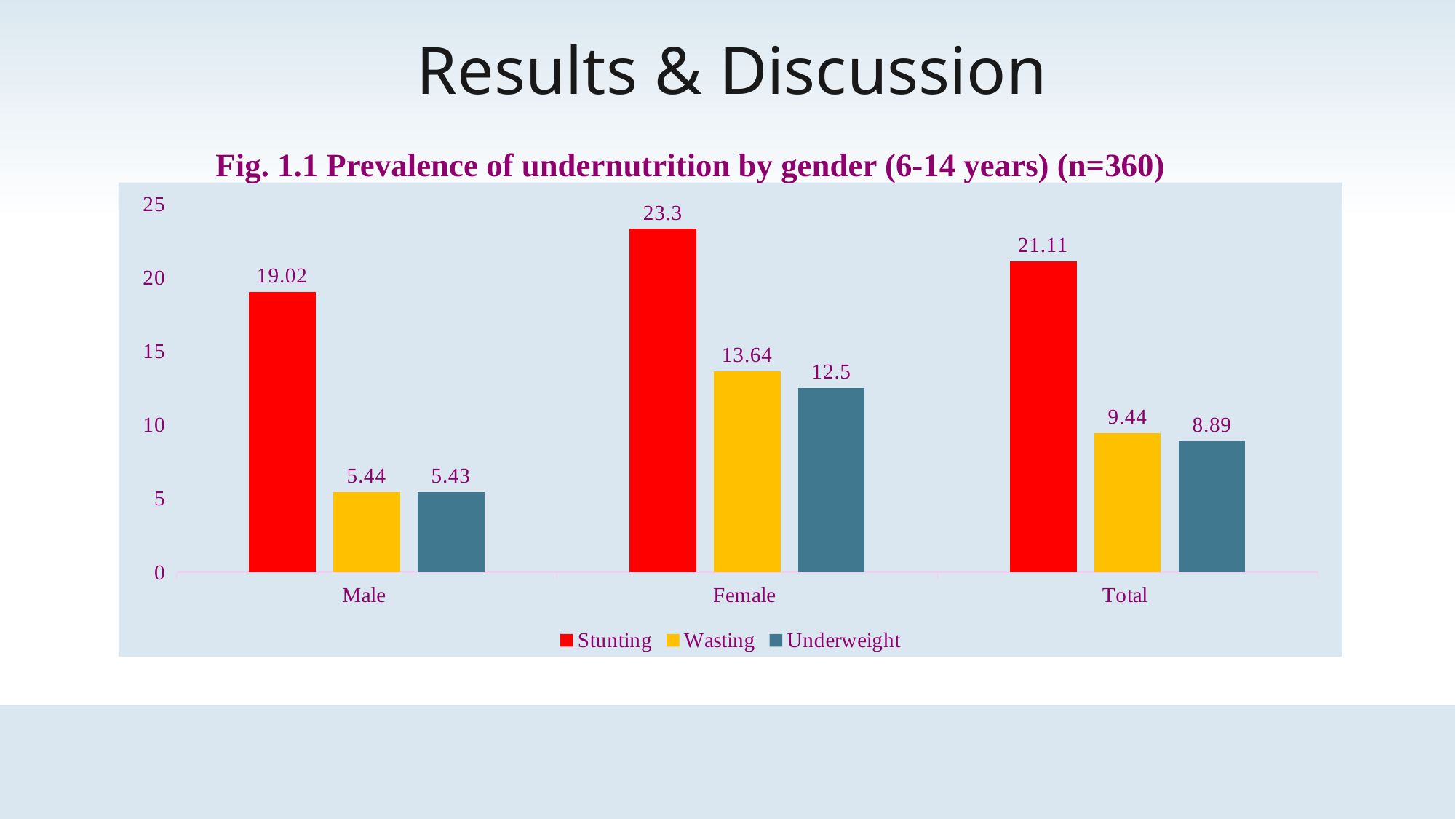
Which category has the highest Stunting value? Female Is the Stunting value for Total greater or less than 20? greater What is the Underweight value for Total? 8.89 What is the Wasting value for Male? 5.44 How many categories are shown on the x axis? 3 What is the title of the chart? Fig. 1.1 Prevalence of undernutrition by gender (6-14 years) (n=360) What is the difference between the Stunting values for Female and Male? 4.28 What kind of chart is shown? bar chart Which is larger, the Wasting value for Female or the Wasting value for Total? Wasting value for Female Which category has the lowest Underweight value? Male How many series does the legend list? 3 What is the Stunting value for Female? 23.3